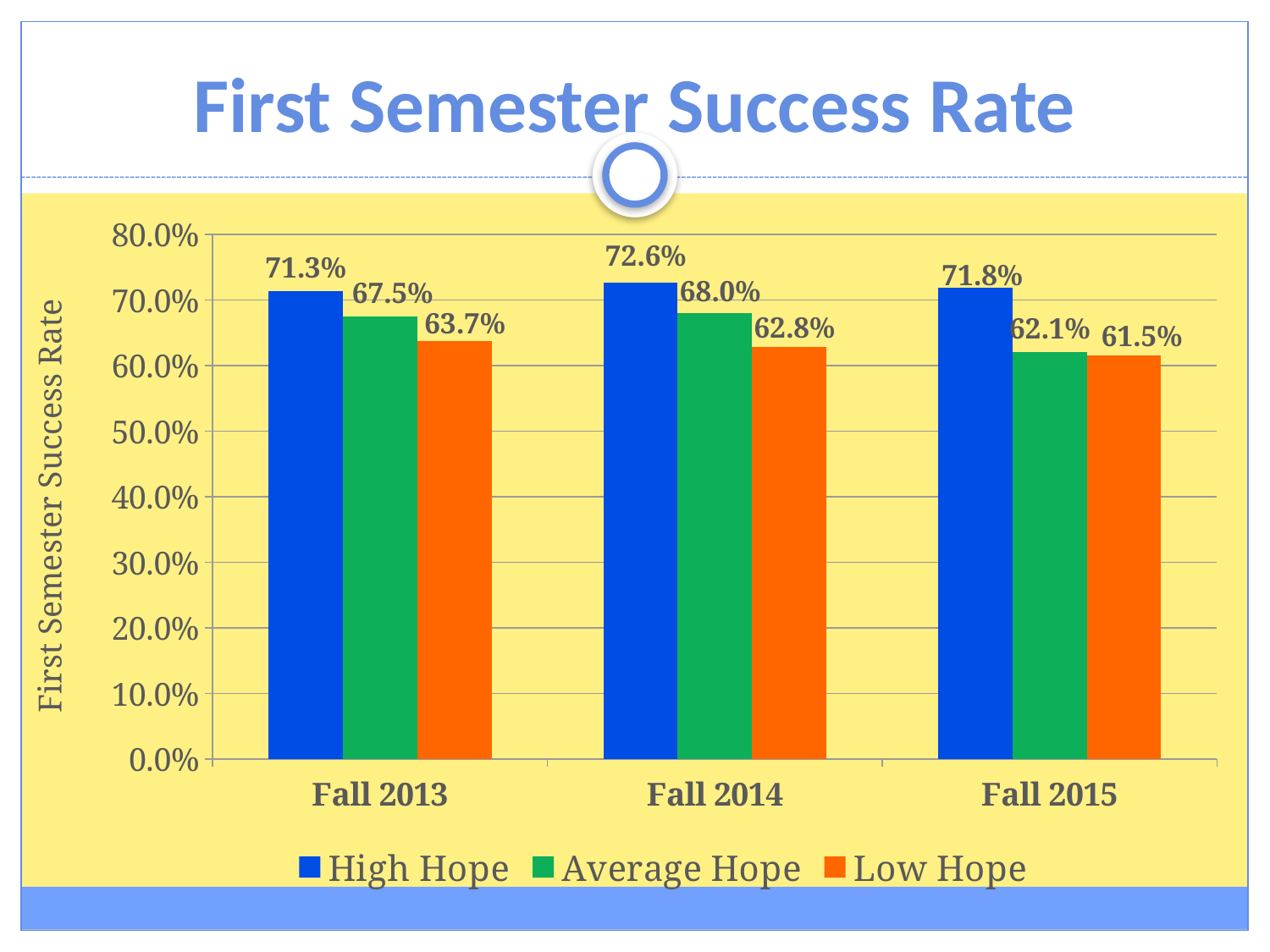
What is the first semester success rate for Average Hope students in Fall 2015? 62.1% Which is larger in Fall 2015: the High Hope success rate or the Average Hope success rate? High Hope What is the difference between the High Hope and Low Hope success rates in Fall 2013? 7.6% What is the first semester success rate for High Hope students in Fall 2014? 72.6% In which semester is the High Hope success rate highest? Fall 2014 How many semesters are shown on the x axis? 3 Which colour represents Low Hope in the chart? Orange How many series does the legend list? 3 What kind of chart is shown on the slide? Bar chart What is the first semester success rate for Low Hope students in Fall 2013? 63.7% In which semester is the Low Hope success rate lowest? Fall 2015 What is the difference between the Average Hope success rates in Fall 2014 and Fall 2015? 5.9%